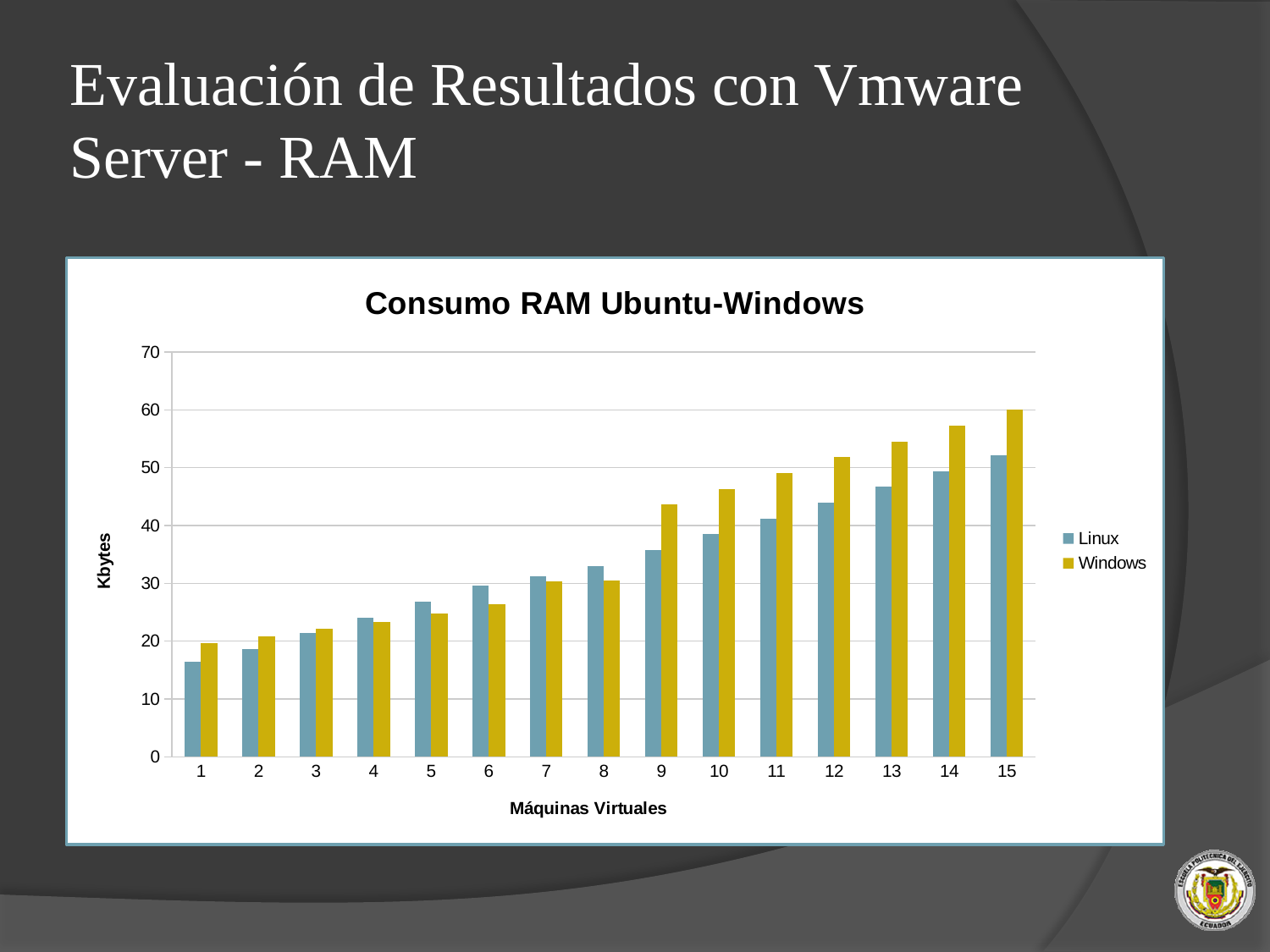
For which number of virtual machines is the Windows value highest? 15 What kind of chart is shown on the slide? bar chart For which number of virtual machines is the Linux value lowest? 1 Is the Linux value for 15 virtual machines greater or less than 50? greater For 9 virtual machines, which series has the larger value, Linux or Windows? Windows What is the title of the chart? Consumo RAM Ubuntu-Windows For 5 virtual machines, which series has the larger value, Linux or Windows? Linux How many series does the legend list? 2 Is the Windows value for 9 virtual machines greater or less than 40? greater Is the Linux value for 1 virtual machine greater or less than 20? less Do the Linux values rise or fall as the number of virtual machines increases? rise How many categories (Máquinas Virtuales) are shown on the x axis? 15